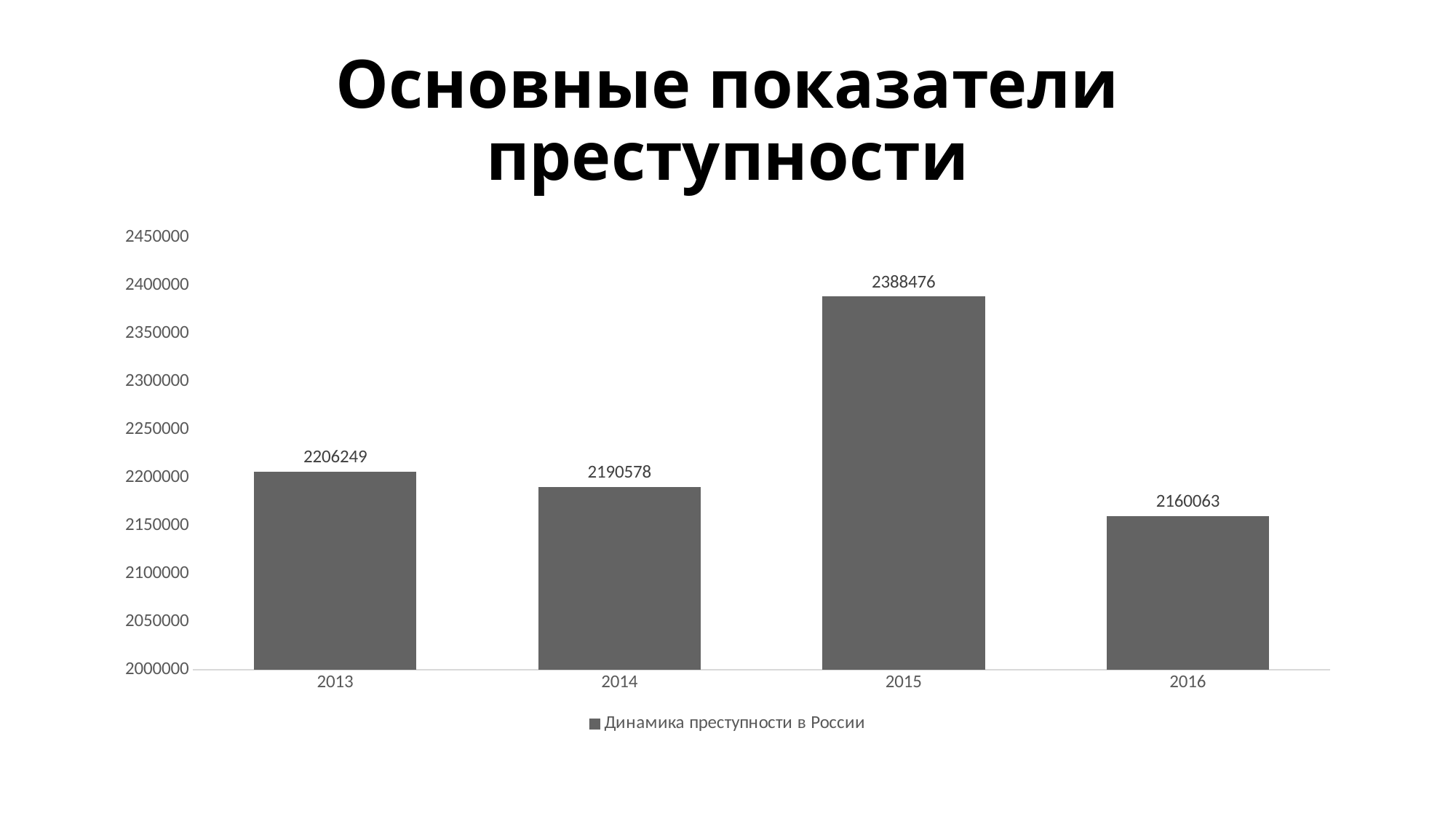
What is the value for 2014? 2190578 Which year has the lowest value? 2016 What is the value for 2013? 2206249 Which year has the highest value? 2015 How many years are shown on the x axis? 4 What is the value for 2016? 2160063 Which is larger, the value for 2013 or the value for 2016? 2013 What is the legend entry for the series? Динамика преступности в России Is the value for 2015 greater or less than 2350000? greater What kind of chart is shown on the slide? bar chart What is the value for 2015? 2388476 What is the difference between the values for 2015 and 2014? 197898